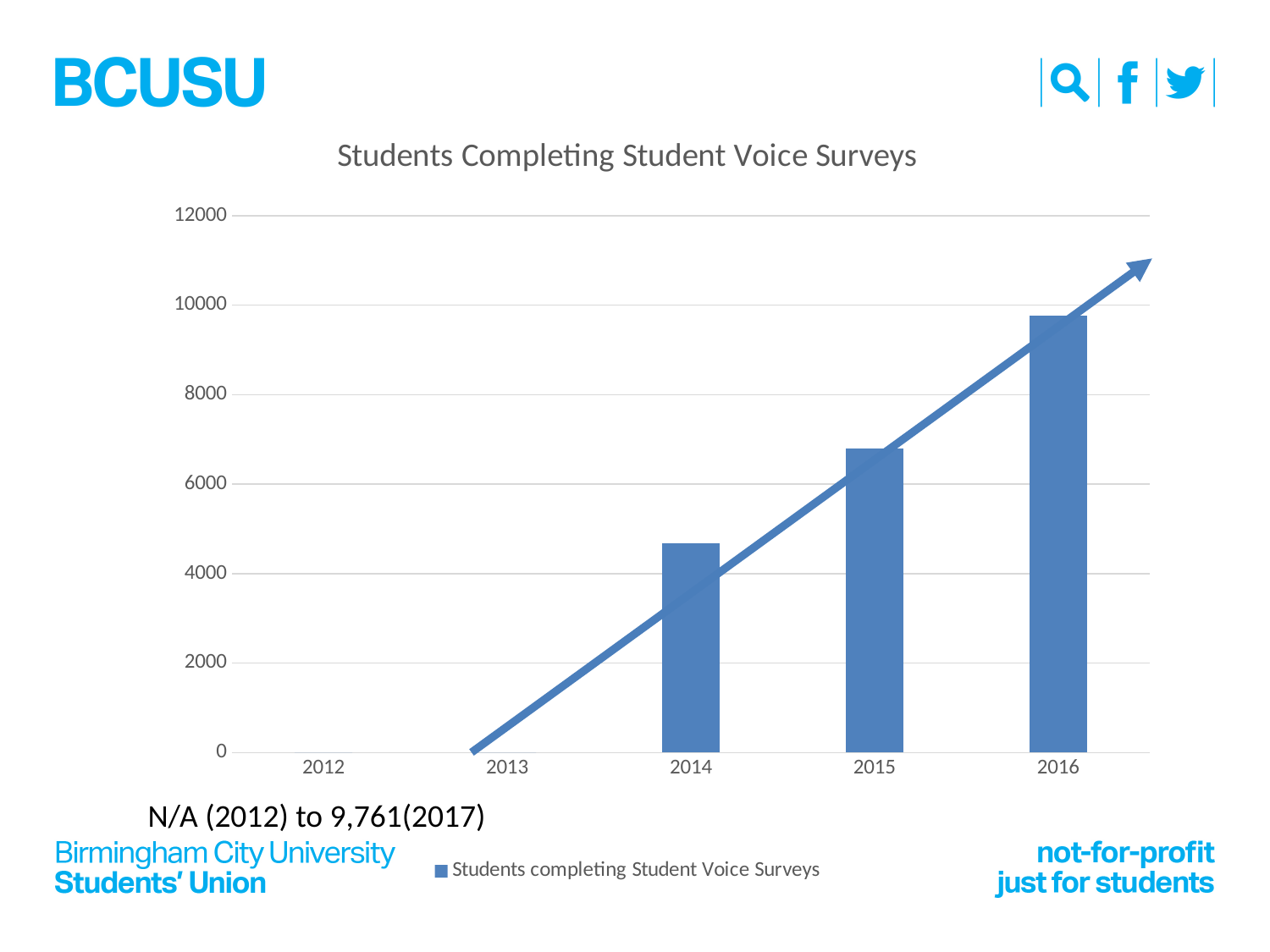
Of the years with a visible bar, which has the shortest bar? 2014 Which is larger, the value for 2014 or the value for 2015? 2015 Is the value for 2015 greater or less than 6000? greater What is the title of the chart? Students Completing Student Voice Surveys Is the value for 2014 greater or less than 6000? less Do the bar values rise or fall from 2014 to 2016? rise How many series does the legend list? 1 Which year has the tallest bar? 2016 What kind of chart is shown on the slide? bar chart Is the value for 2016 greater or less than 8000? greater How many years are labelled on the x axis? 5 What is the name of the series shown in the legend? Students completing Student Voice Surveys